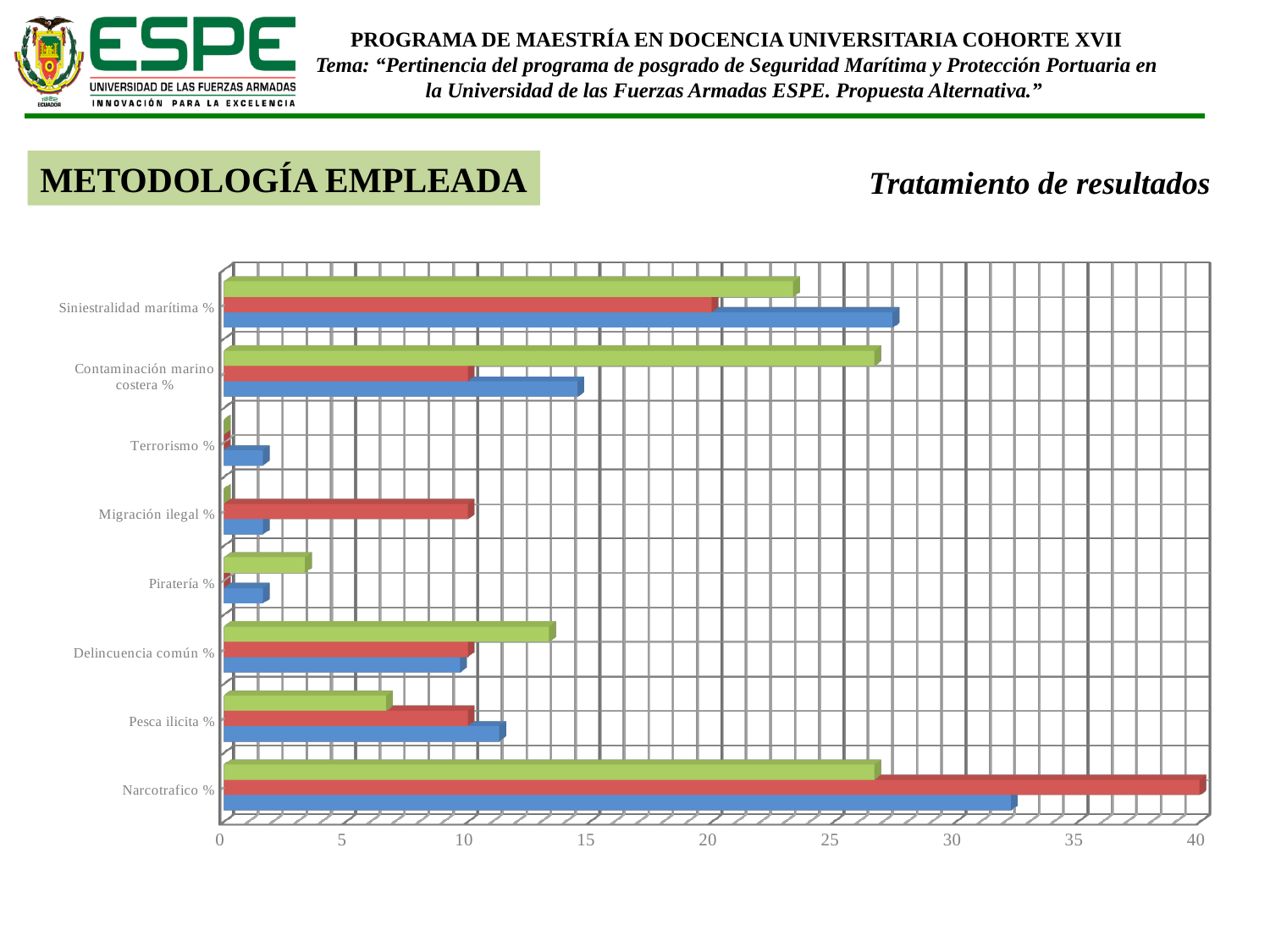
Which category has the longest red bar? Narcotrafico % Is the red bar for Narcotrafico % greater or less than 35? greater How many bars are plotted for each category in the chart? 3 Is the blue bar for Siniestralidad marítima % greater or less than 25? greater Is the blue bar for Narcotrafico % greater or less than 30? greater Which category has the longest blue bar? Narcotrafico % For Contaminación marino costera %, which bar is longer, the green one or the blue one? green For Migración ilegal %, which bar is longer, the red one or the blue one? red How many categories are listed on the vertical axis of the chart? 8 What kind of chart is shown on the slide? bar chart